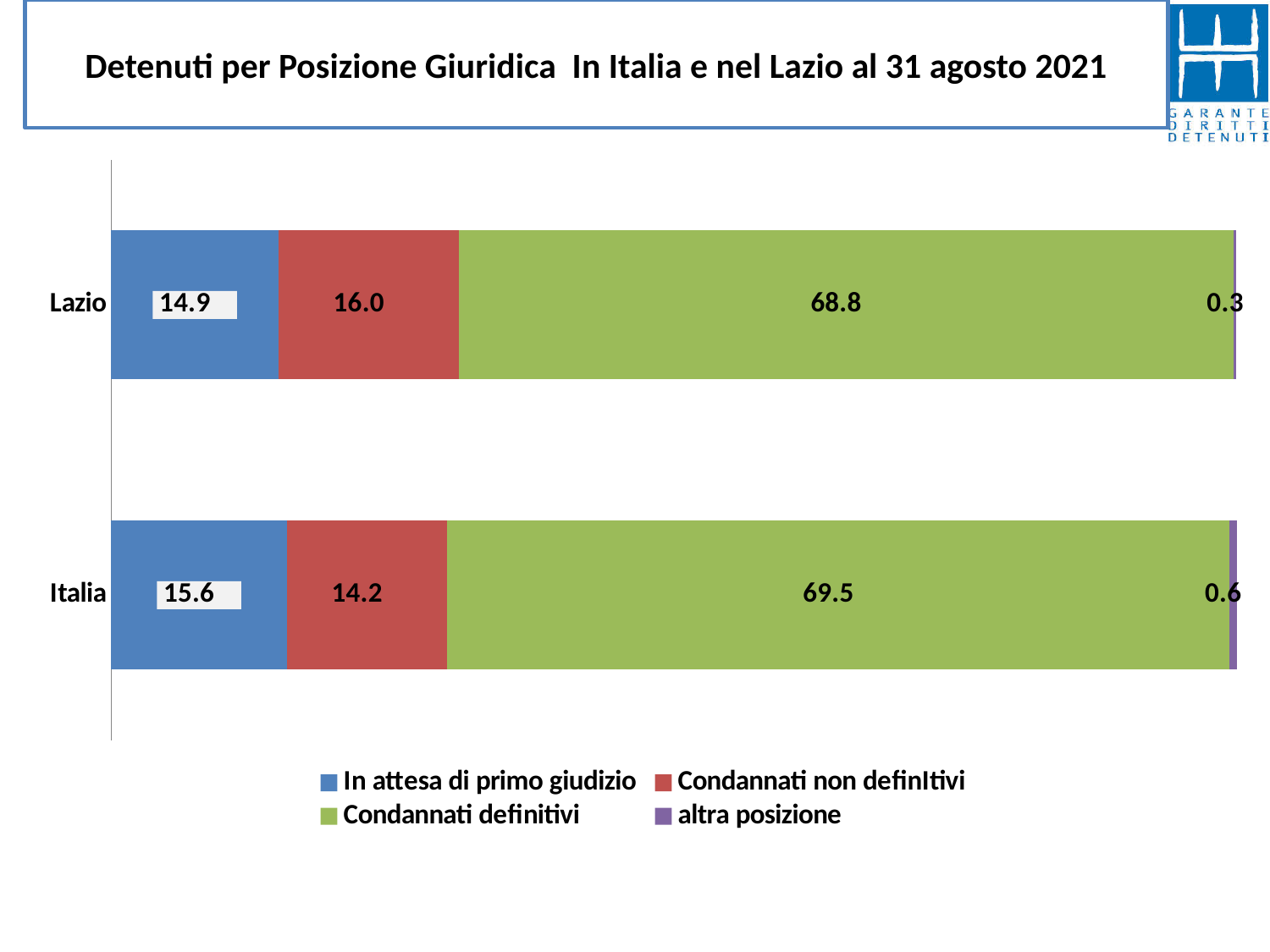
What is the value for 'In attesa di primo giudizio' in Italia? 15.6 What is the difference between the 'Condannati non definItivi' values for Lazio and Italia? 1.8 What is the value for 'Condannati definitivi' in Lazio? 68.8 What kind of chart is shown on the slide? Stacked bar chart Which series has the largest value in the Italia bar? Condannati definitivi What is the total of the Lazio stacked bar? 100.0 What is the value for 'Condannati non definItivi' in Lazio? 16.0 Which series has the smallest value in the Lazio bar? altra posizione How many categories (regions) are shown on the chart? 2 Which is larger, the 'In attesa di primo giudizio' value for Lazio or for Italia? Italia What is the value for 'altra posizione' in Italia? 0.6 How many series does the legend list? 4